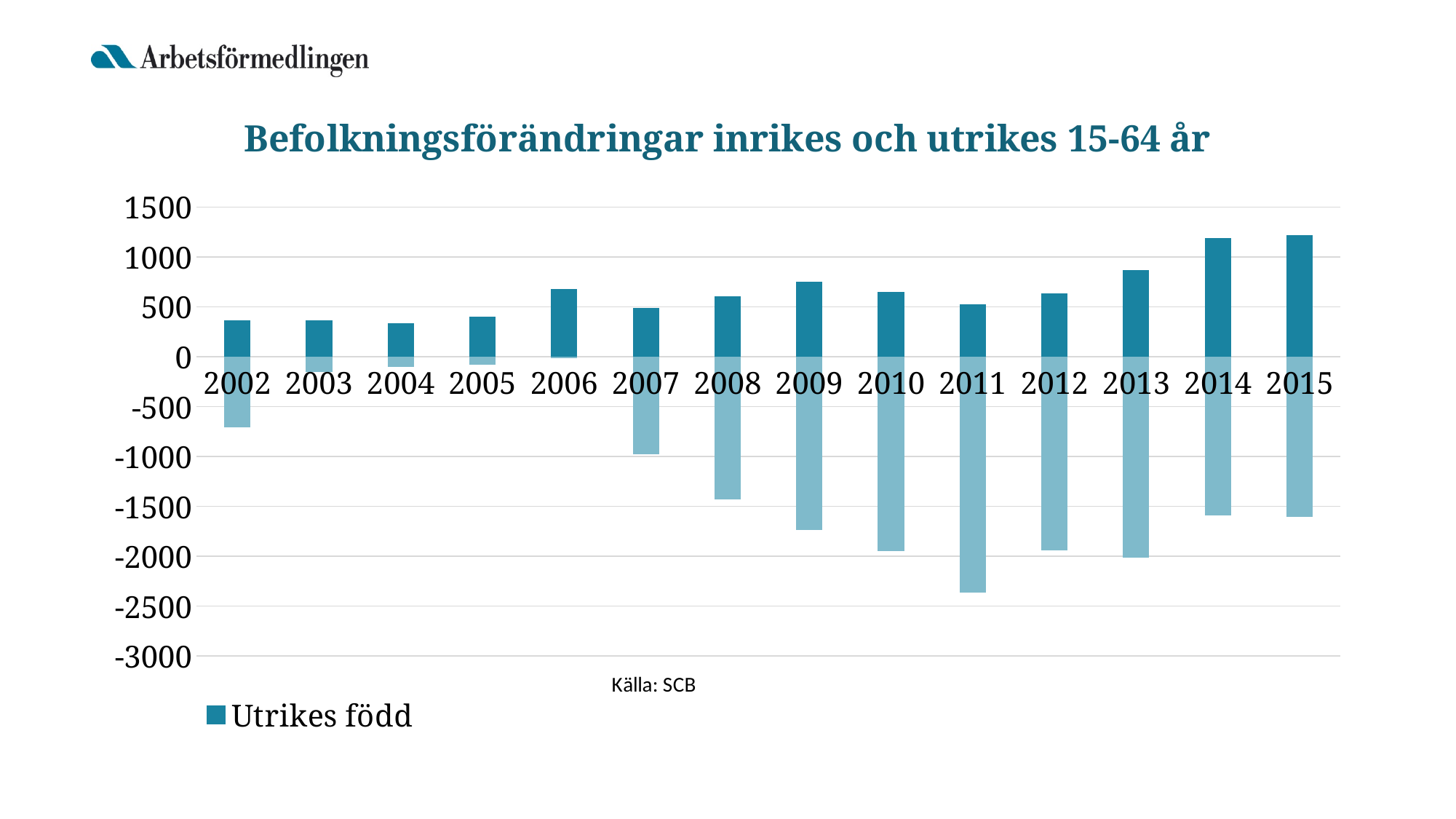
Which is larger, the Utrikes född value for 2013 or for 2012? 2013 Is the value for Utrikes född in 2009 greater or less than 500? greater Is the value for Utrikes född in 2013 greater or less than 1000? less How many years are shown on the x axis of the chart? 14 What is the title of the chart? Befolkningsförändringar inrikes och utrikes 15-64 år How many series does the legend list? 1 What kind of chart is shown on the slide? bar chart Is the value for Utrikes född in 2004 greater or less than 500? less What series name is shown in the legend? Utrikes född Which is larger, the Utrikes född value for 2014 or for 2006? 2014 In which year does the bar extend furthest below zero? 2011